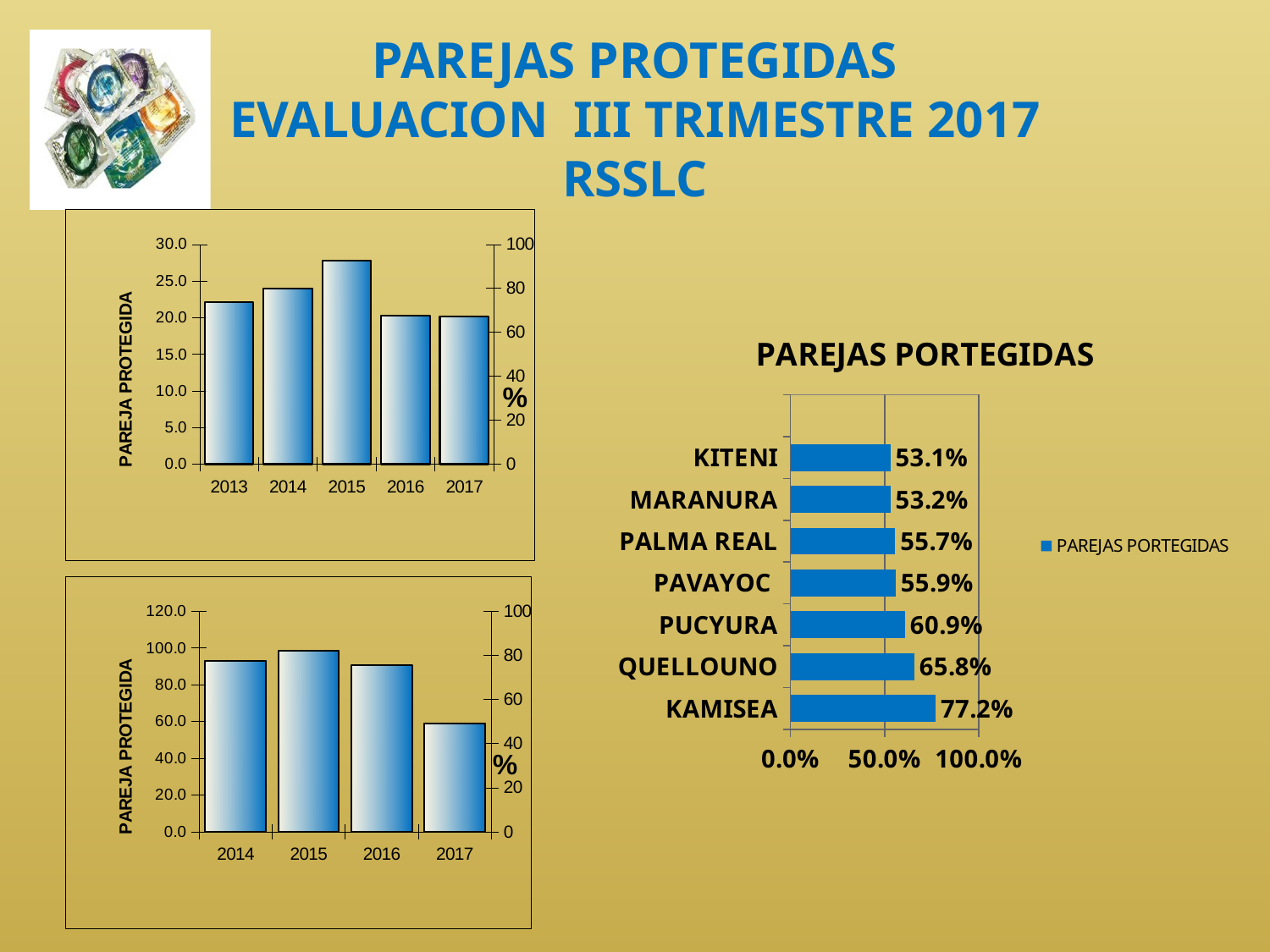
In the PAREJAS PORTEGIDAS chart on the right, what is the value for PUCYURA? 60.9% In the PAREJAS PORTEGIDAS chart on the right, how many categories are shown? 7 In the bottom-left chart, which year has the lowest bar? 2017 In the PAREJAS PORTEGIDAS chart on the right, which category has the lowest value? KITENI In the top-left chart, is the value for 2015 greater or less than 25.0? greater In the bottom-left chart, is the value for 2017 greater or less than 80.0? less In the PAREJAS PORTEGIDAS chart on the right, how many series does the legend list? 1 In the top-left chart, which year has the highest bar? 2015 In the PAREJAS PORTEGIDAS chart on the right, which category has the highest value? KAMISEA In the PAREJAS PORTEGIDAS chart on the right, what is the value for KAMISEA? 77.2% In the PAREJAS PORTEGIDAS chart on the right, what is the difference between the values for KAMISEA and QUELLOUNO? 11.4% In the top-left chart, how many years are shown on the x axis? 5